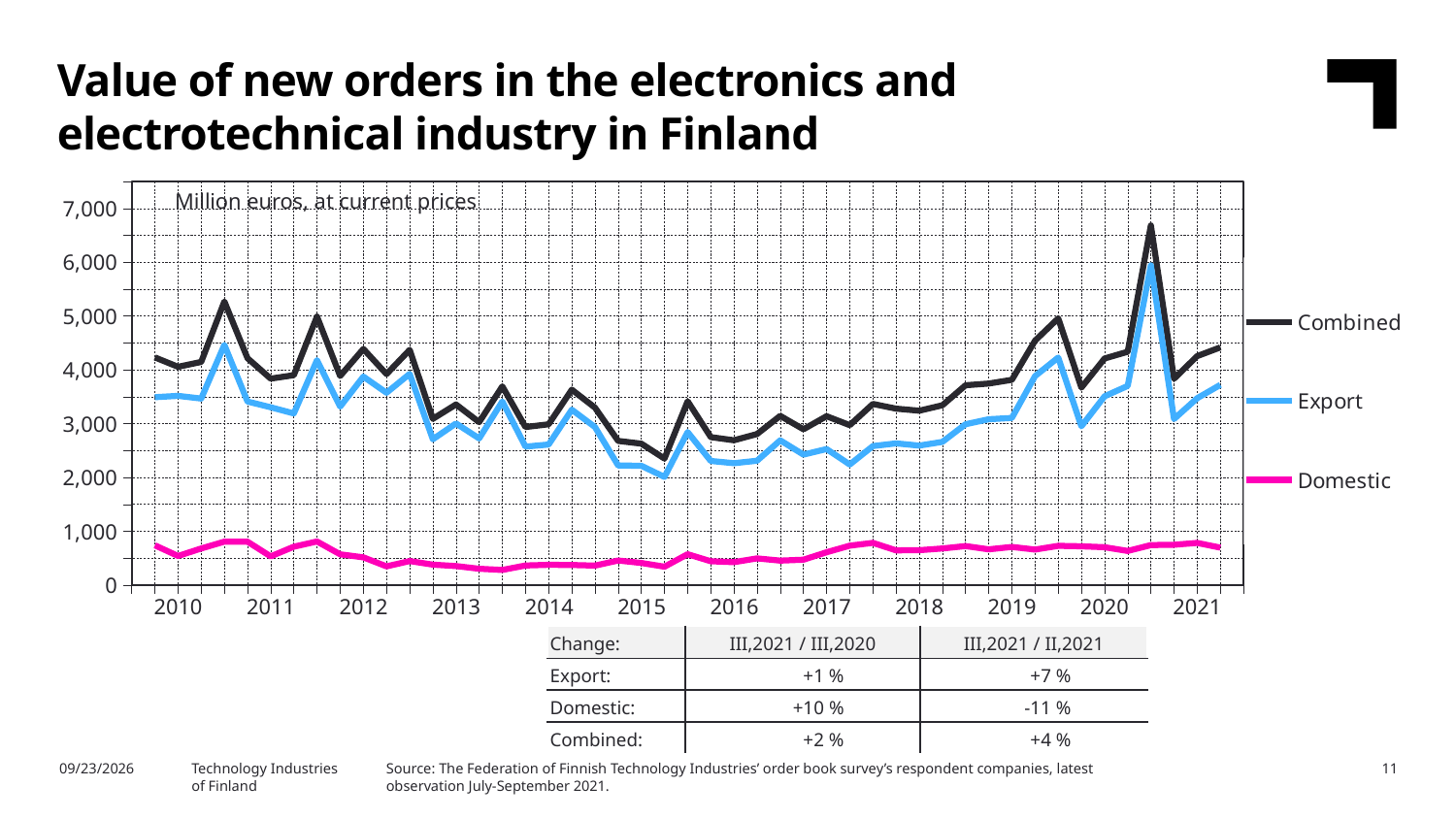
Is the Domestic series ever greater or less than 1,000 across the whole period? less What kind of chart is shown on the slide? line chart What unit is stated at the top of the chart area? Million euros, at current prices Does the Combined series rise or fall between 2015 and 2019? rise Is the lowest value of the Combined series in 2015 greater or less than 3,000? less Which is larger in 2021, the Export series or the Domestic series? Export Which series has the highest values throughout the chart? Combined Is the peak value of the Combined series in 2020 greater or less than 6,000? greater Which series are listed in the legend? Combined, Export, Domestic How many years are labelled on the x axis? 12 How many series does the legend list? 3 Which series has the lowest values throughout the chart? Domestic